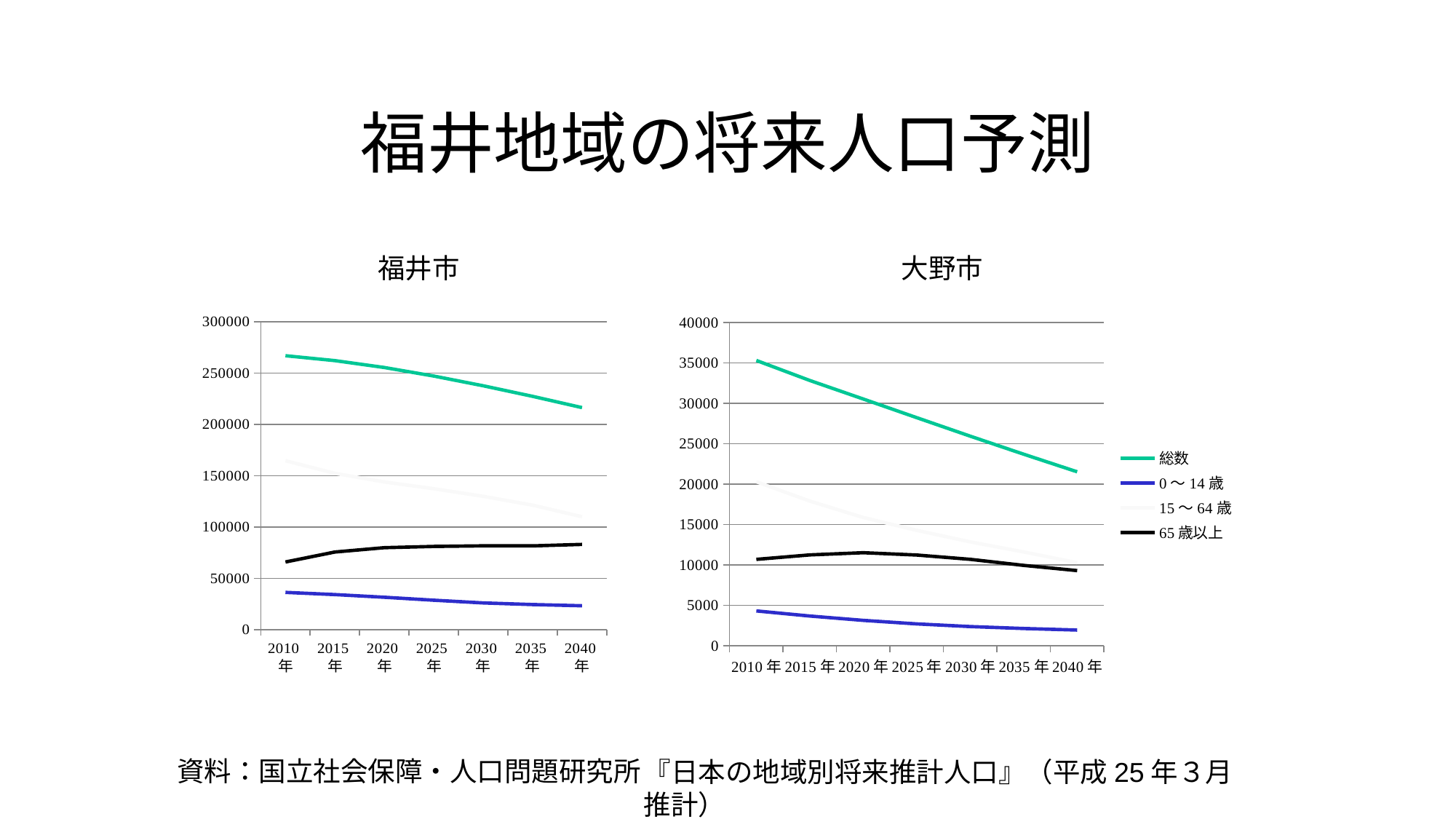
In the 大野市 chart, does the 総数 line rise or fall from 2010年 to 2040年? fall In the 福井市 chart, which series has the lowest values across all years? 0～14歳 In the 福井市 chart, is the value of 総数 for 2010年 greater or less than 250000? greater What kind of chart is the 福井市 chart? line chart In the 福井市 chart, is the value of 0～14歳 for 2010年 greater or less than 50000? less In the 福井市 chart, is the value of 65歳以上 for 2040年 greater or less than 100000? less How many years are plotted on the x axis of the 大野市 chart? 7 How many series does the legend list? 4